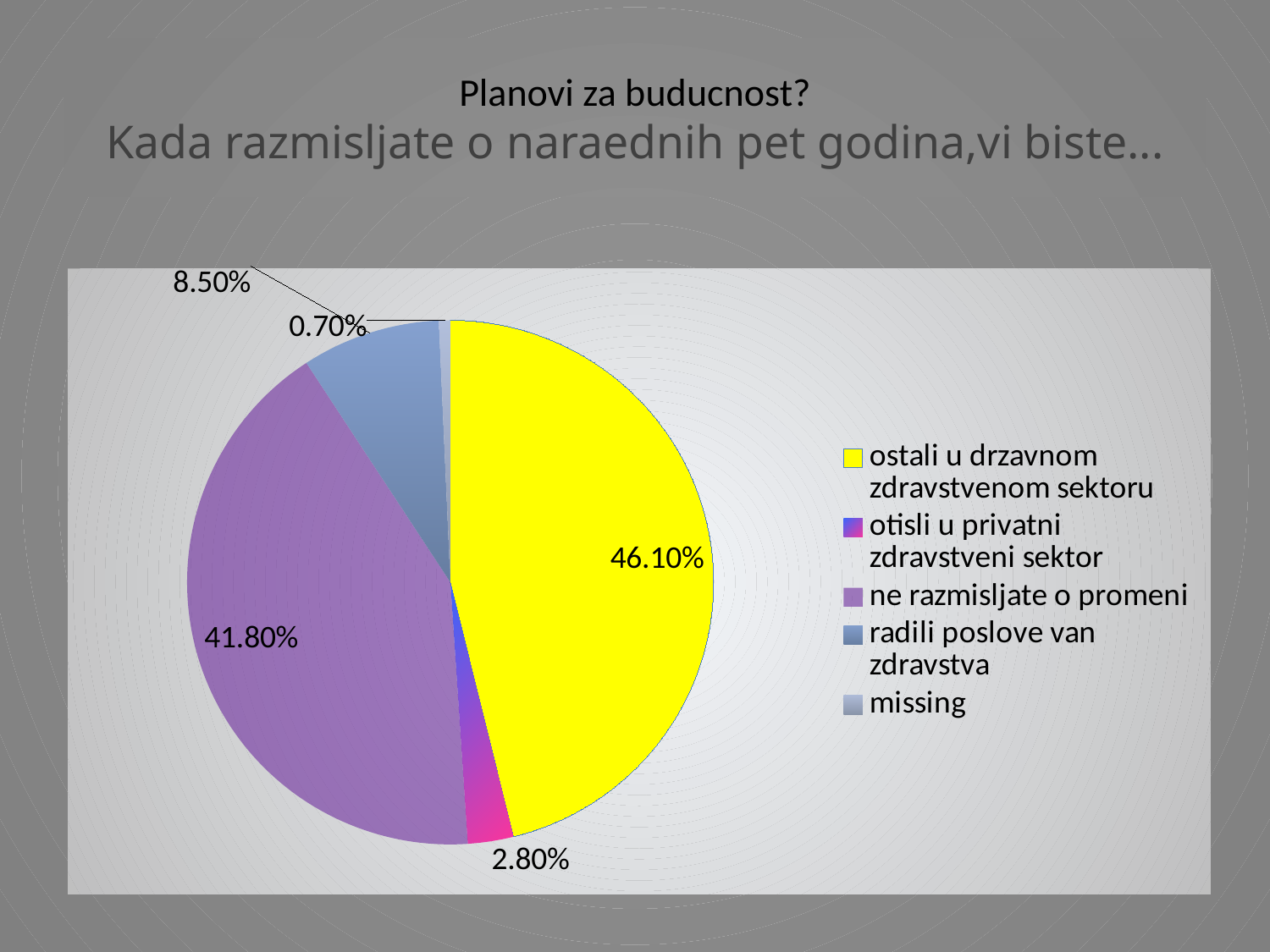
What percentage is shown for "radili poslove van zdravstva"? 8.50% Which category has the largest share of the pie? ostali u drzavnom zdravstvenom sektoru Which is larger: the share for "radili poslove van zdravstva" or the share for "otisli u privatni zdravstveni sektor"? radili poslove van zdravstva What percentage is shown for "ne razmisljate o promeni"? 41.80% What is the difference in percentage points between "ostali u drzavnom zdravstvenom sektoru" and "ne razmisljate o promeni"? 4.30 What kind of chart is shown on the slide? pie chart How many categories does the legend list? 5 What percentage is shown for "otisli u privatni zdravstveni sektor"? 2.80% What percentage is shown for "missing"? 0.70% What colour is the slice for "ne razmisljate o promeni"? purple Which category has the smallest share of the pie? missing What percentage of the pie is labelled for "ostali u drzavnom zdravstvenom sektoru"? 46.10%